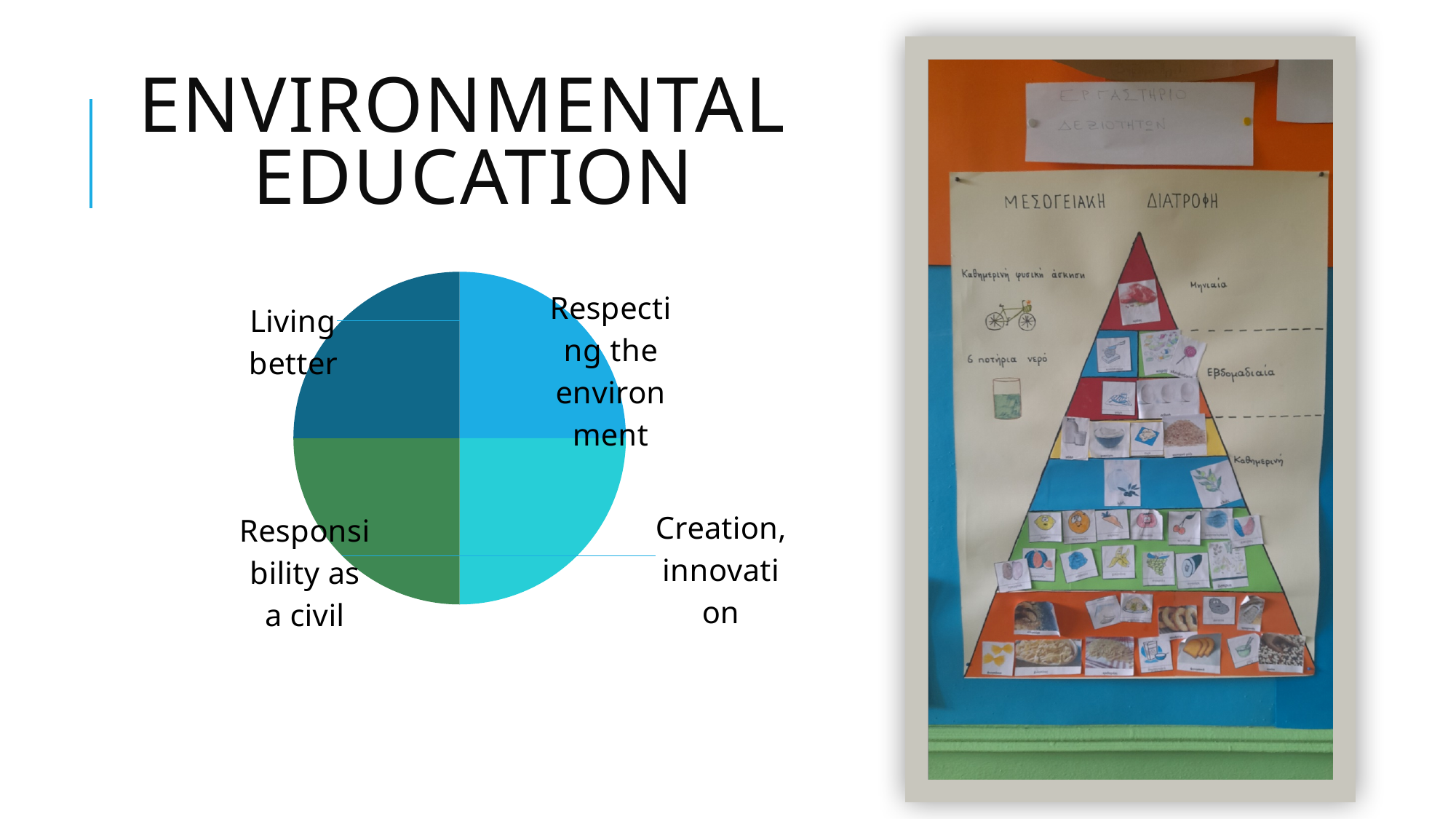
Does the pie chart display any numeric data labels? No How many slices does the pie chart have? 4 Are the four slices of the pie chart visibly equal in size or clearly different? equal What is the label of the light blue slice in the upper-right quarter of the pie chart? Respecting the environment What kind of chart is shown on the slide? pie chart Which slice of the pie chart is coloured turquoise (lower right)? Creation, innovation Which slice of the pie chart is coloured green? Responsibility as a civil Which slice of the pie chart is labelled in the upper-left quarter? Living better